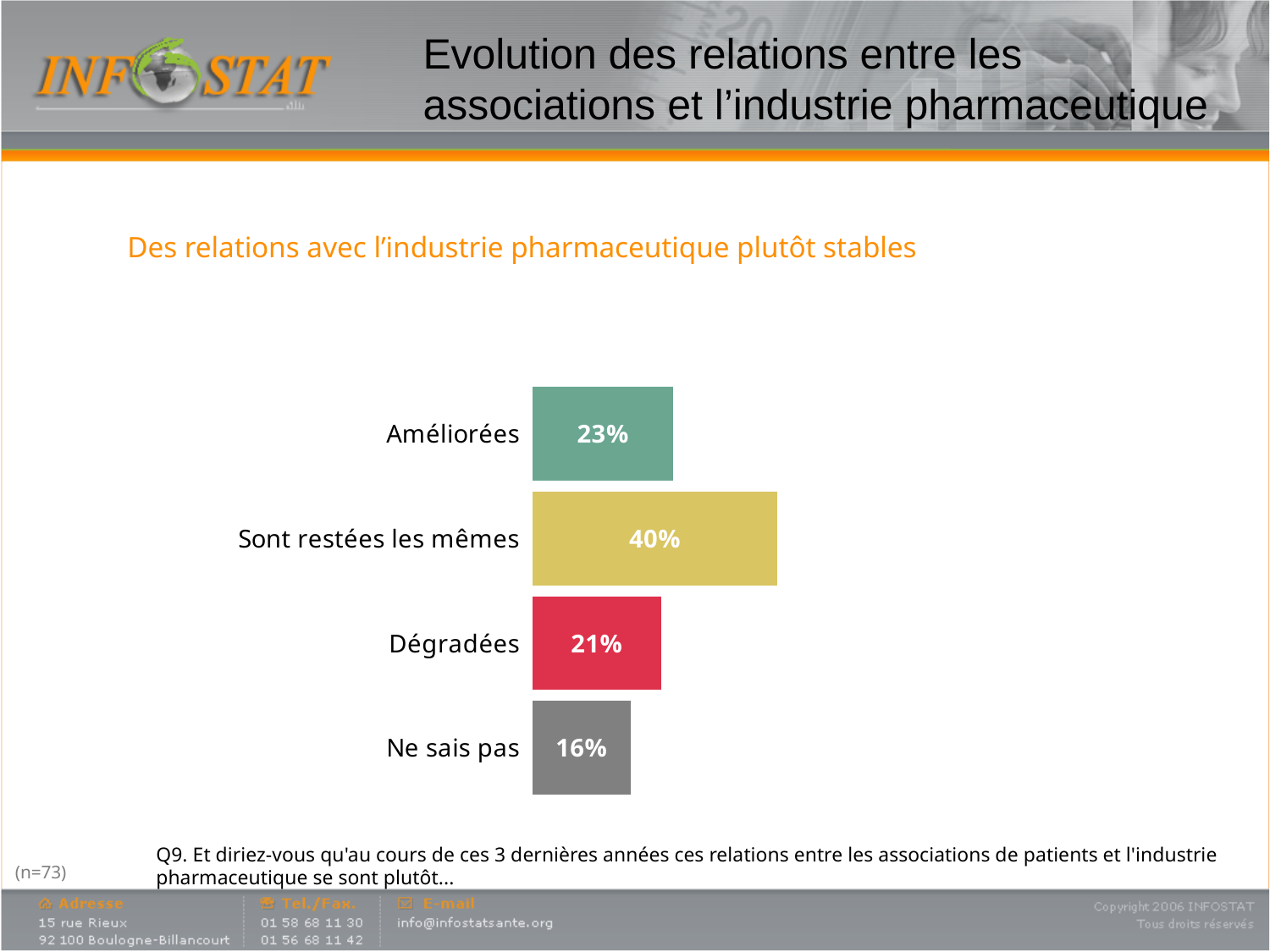
What is the value for "Améliorées"? 23% What kind of chart is shown on the slide? Bar chart What is the difference between the values for "Sont restées les mêmes" and "Améliorées"? 17% Which is larger, the value for "Améliorées" or the value for "Ne sais pas"? Améliorées What colour is the bar for "Dégradées"? Red What is the value for "Sont restées les mêmes"? 40% Which category has the lowest value? Ne sais pas Which category has the highest value? Sont restées les mêmes What is the value for "Ne sais pas"? 16% How many categories are shown in the chart? 4 What is the difference between the values for "Dégradées" and "Ne sais pas"? 5% What is the value for "Dégradées"? 21%